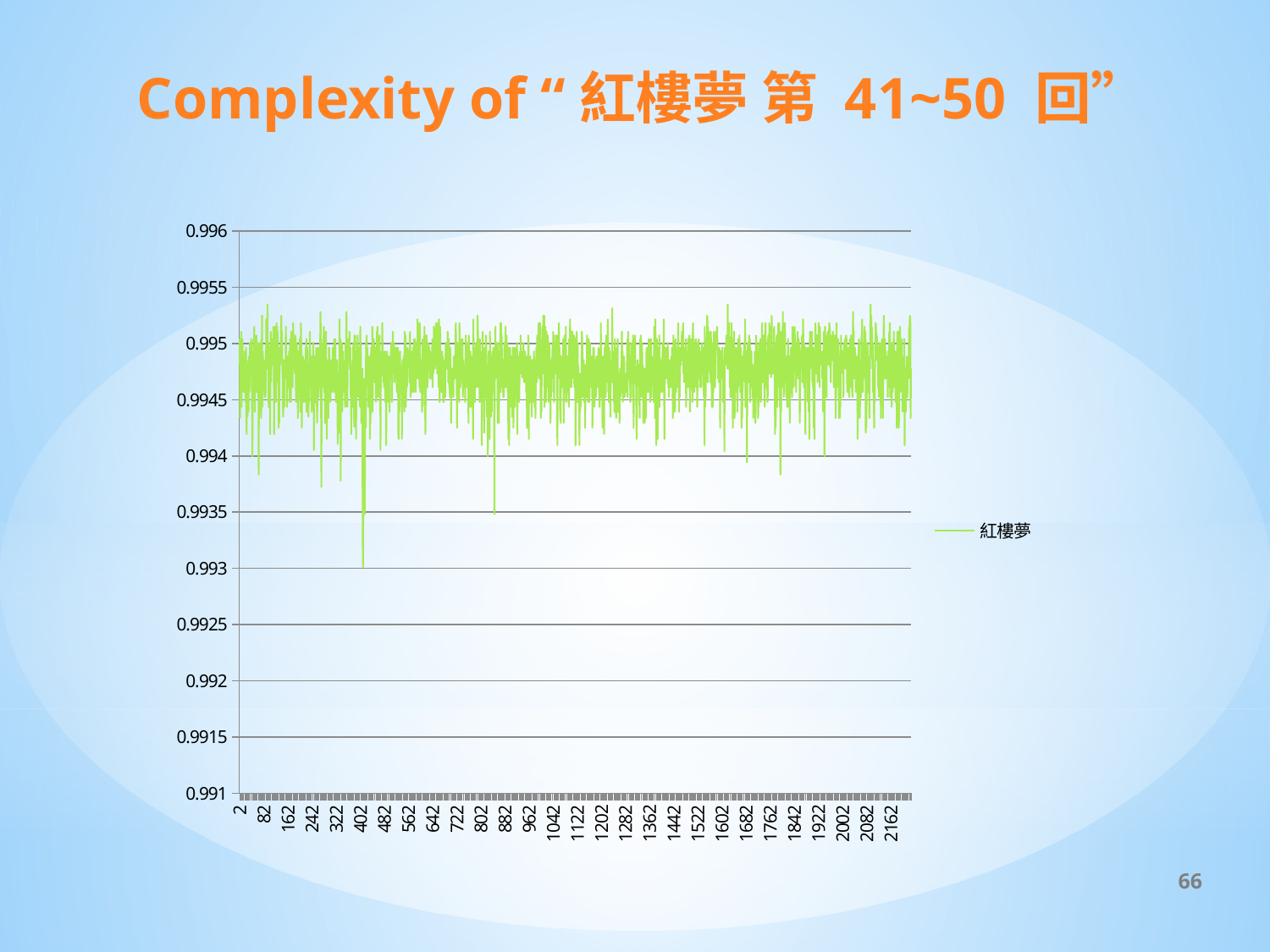
Is the highest value of the 紅樓夢 series greater or less than 0.995? greater Is the lowest value of the 紅樓夢 series greater or less than 0.9925? greater Is the highest value of the 紅樓夢 series greater or less than 0.9955? less What is the name of the series shown in the legend? 紅樓夢 What kind of chart is shown on the slide? line chart How many series does the legend list? 1 What is the lowest value shown on the y axis? 0.991 What is the title of the slide containing the chart? Complexity of “ 紅樓夢 第 41~50 回” Do the values of the 紅樓夢 series show a clear rising or falling trend along the x axis, or do they stay roughly level? stay roughly level